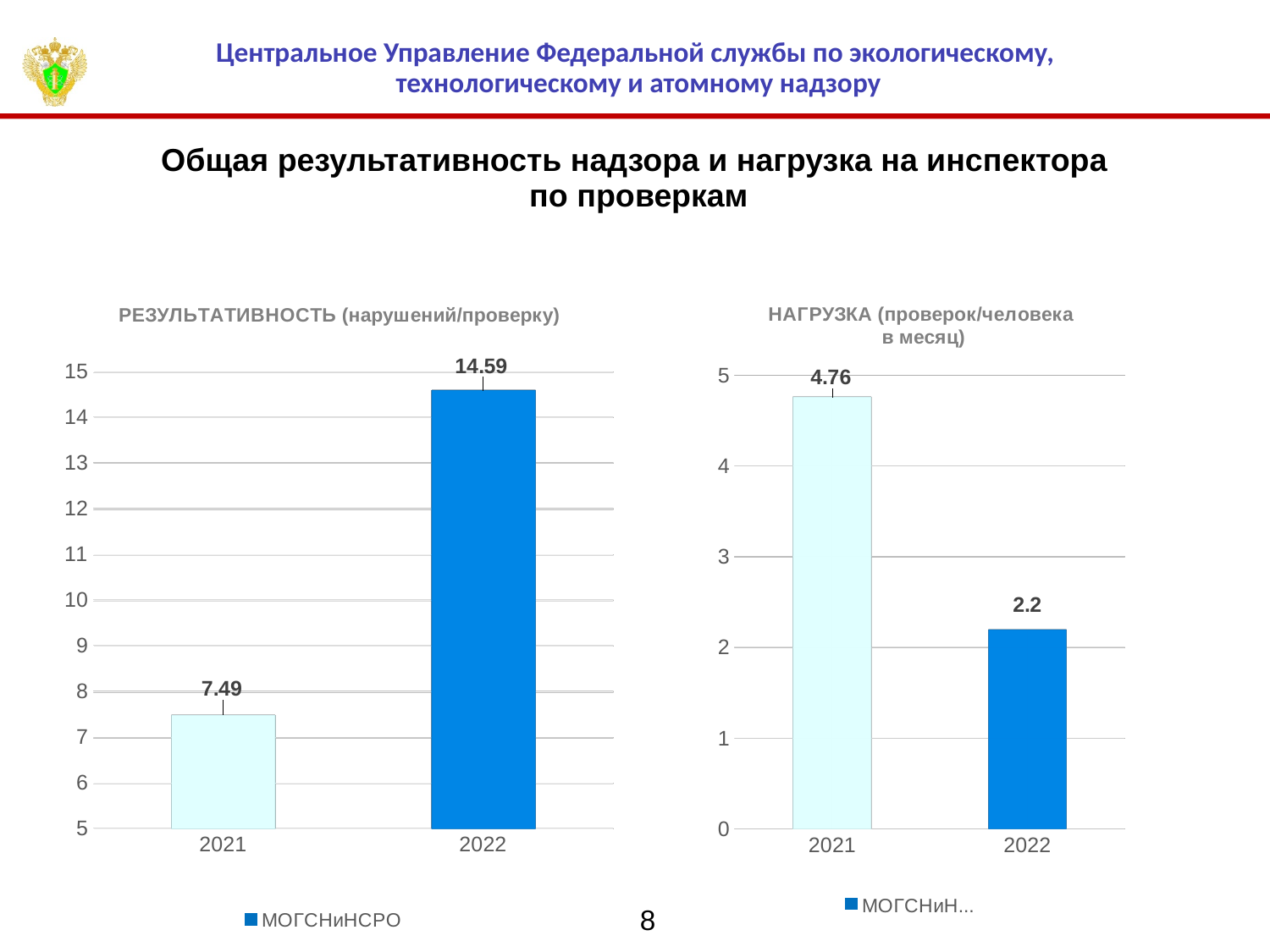
In the НАГРУЗКА (проверок/человека в месяц) chart, do the values rise or fall from 2021 to 2022? fall In the НАГРУЗКА (проверок/человека в месяц) chart, what is the difference between the 2021 and 2022 values? 2.56 In the НАГРУЗКА (проверок/человека в месяц) chart, what is the value for 2021? 4.76 How many categories are shown on the x axis of the НАГРУЗКА (проверок/человека в месяц) chart? 2 In the РЕЗУЛЬТАТИВНОСТЬ (нарушений/проверку) chart, which year has the higher value? 2022 In the РЕЗУЛЬТАТИВНОСТЬ (нарушений/проверку) chart, what is the value for 2021? 7.49 In the НАГРУЗКА (проверок/человека в месяц) chart, which year has the lower value? 2022 In the НАГРУЗКА (проверок/человека в месяц) chart, what is the value for 2022? 2.2 What kind of chart is the РЕЗУЛЬТАТИВНОСТЬ (нарушений/проверку) chart? bar chart In the РЕЗУЛЬТАТИВНОСТЬ (нарушений/проверку) chart, do the values rise or fall from 2021 to 2022? rise In the РЕЗУЛЬТАТИВНОСТЬ (нарушений/проверку) chart, what is the value for 2022? 14.59 In the РЕЗУЛЬТАТИВНОСТЬ (нарушений/проверку) chart, what is the difference between the 2022 and 2021 values? 7.1